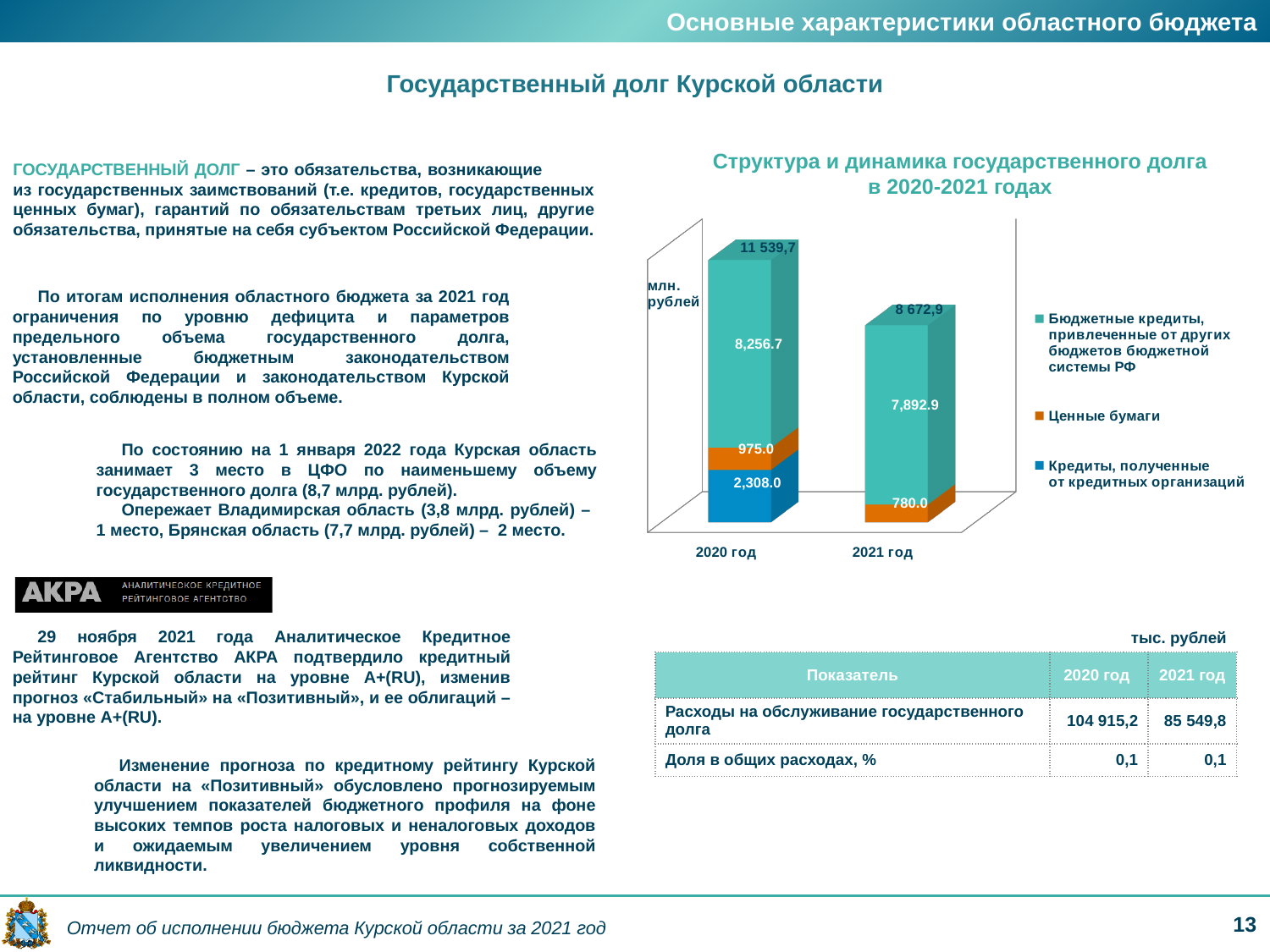
What is the total government debt shown above the bar for 2021 год? 8 672,9 How many years (categories) are shown on the x axis of the debt structure chart? 2 What type of chart is shown under the title «Структура и динамика государственного долга в 2020-2021 годах»? Stacked bar chart What is the value of «Бюджетные кредиты, привлеченные от других бюджетов бюджетной системы РФ» for 2020 год? 8,256.7 How many series does the legend of the debt structure chart list? 3 What is the total government debt shown above the bar for 2020 год? 11 539,7 Does the total government debt rise or fall from 2020 год to 2021 год? Fall What is the value of «Кредиты, полученные от кредитных организаций» for 2020 год? 2,308.0 What is the value of «Ценные бумаги» for 2021 год? 780.0 By how much did «Ценные бумаги» change from 2020 год (975.0) to 2021 год (780.0)? 195.0 Which year has the higher total government debt, 2020 год or 2021 год? 2020 год What unit is indicated on the vertical axis of the debt structure chart? млн. рублей